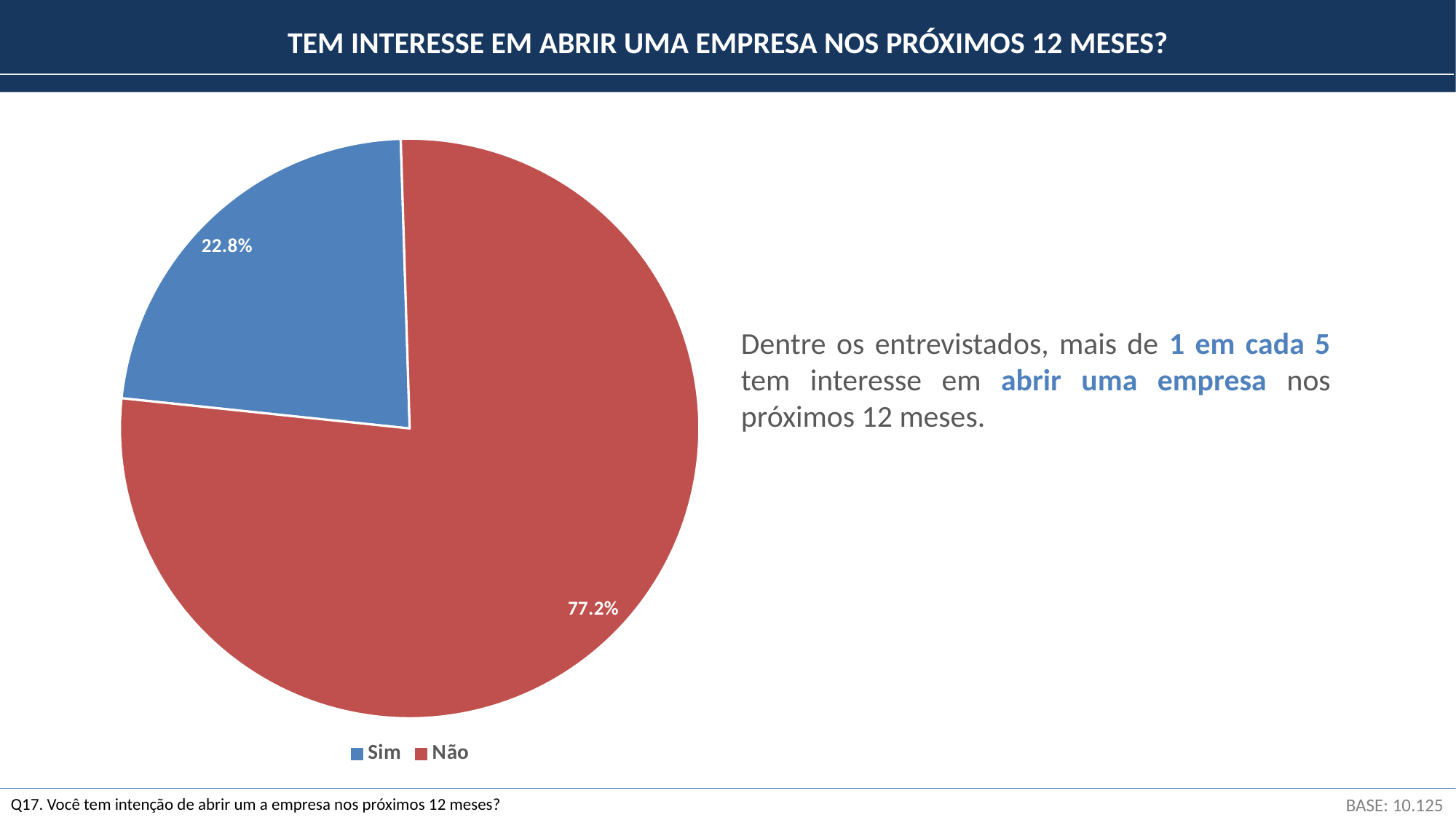
What colour is the "Sim" slice? blue Which slice of the pie is the smallest? Sim What share of respondents answered "Sim"? 22.8% What is the share of the pie taken by the "Sim" slice? 22.8% How many entries does the legend list? 2 What is the difference in percentage points between the "Não" and "Sim" slices? 54.4 What kind of chart is shown on the slide? pie chart What share of respondents answered "Não"? 77.2% How many slices does the pie chart have? 2 What colour is the "Não" slice? red Which slice of the pie is the largest? Não Which is larger, the "Sim" slice or the "Não" slice? Não